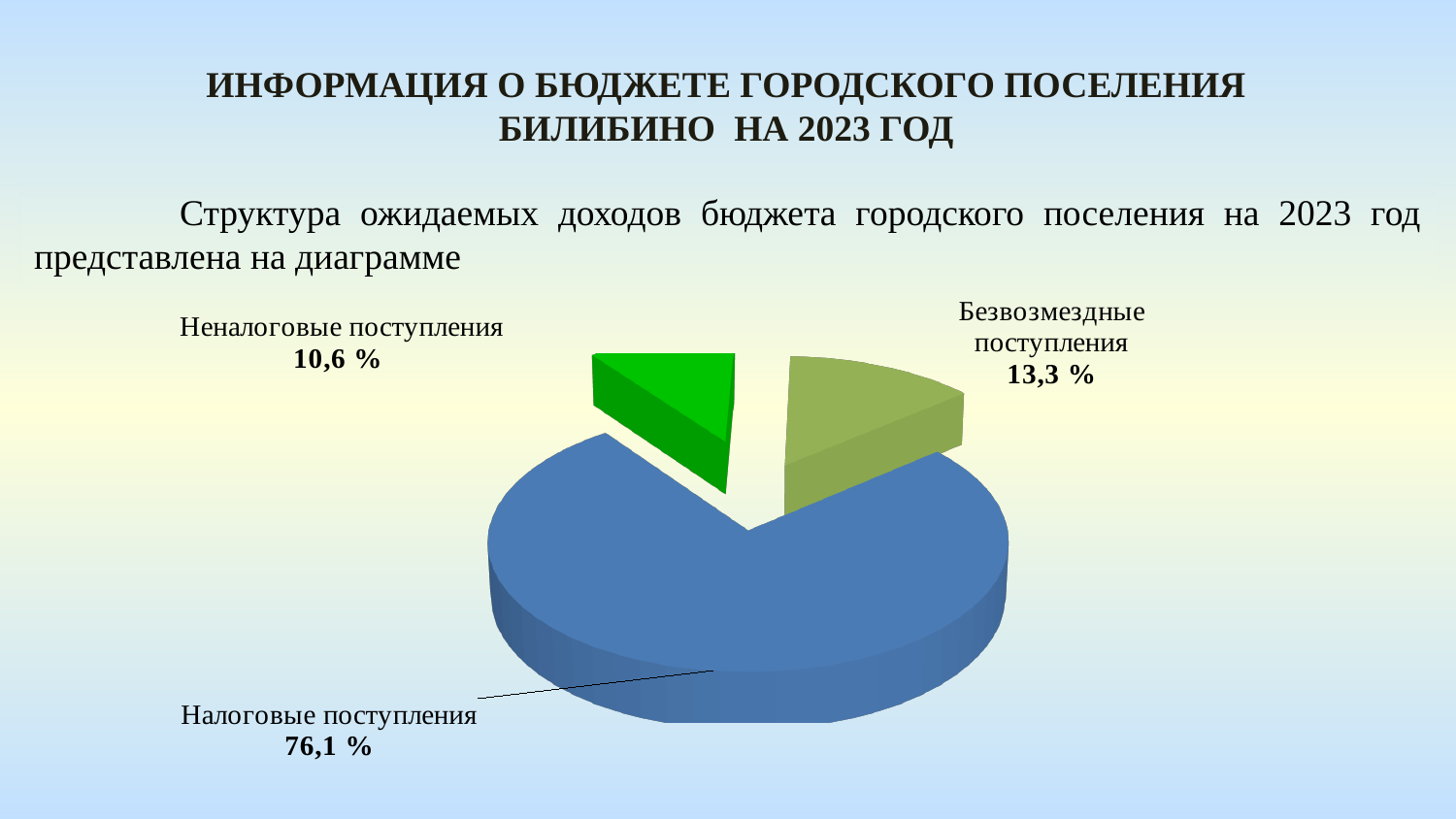
What is the difference between "Налоговые поступления" and "Безвозмездные поступления"? 62,8 % Which year does the budget information on the slide refer to? 2023 How many slices does the pie chart have? 3 What share of the pie is labelled "Налоговые поступления"? 76,1 % What is the value shown for "Неналоговые поступления"? 10,6 % Which category has the smallest slice of the pie? Неналоговые поступления What is the difference between "Безвозмездные поступления" and "Неналоговые поступления"? 2,7 % Which is larger: "Безвозмездные поступления" or "Неналоговые поступления"? Безвозмездные поступления What is the value shown for "Безвозмездные поступления"? 13,3 % What kind of chart is shown on the slide? pie chart What colour is the slice for "Налоговые поступления"? blue Which category has the largest slice of the pie? Налоговые поступления